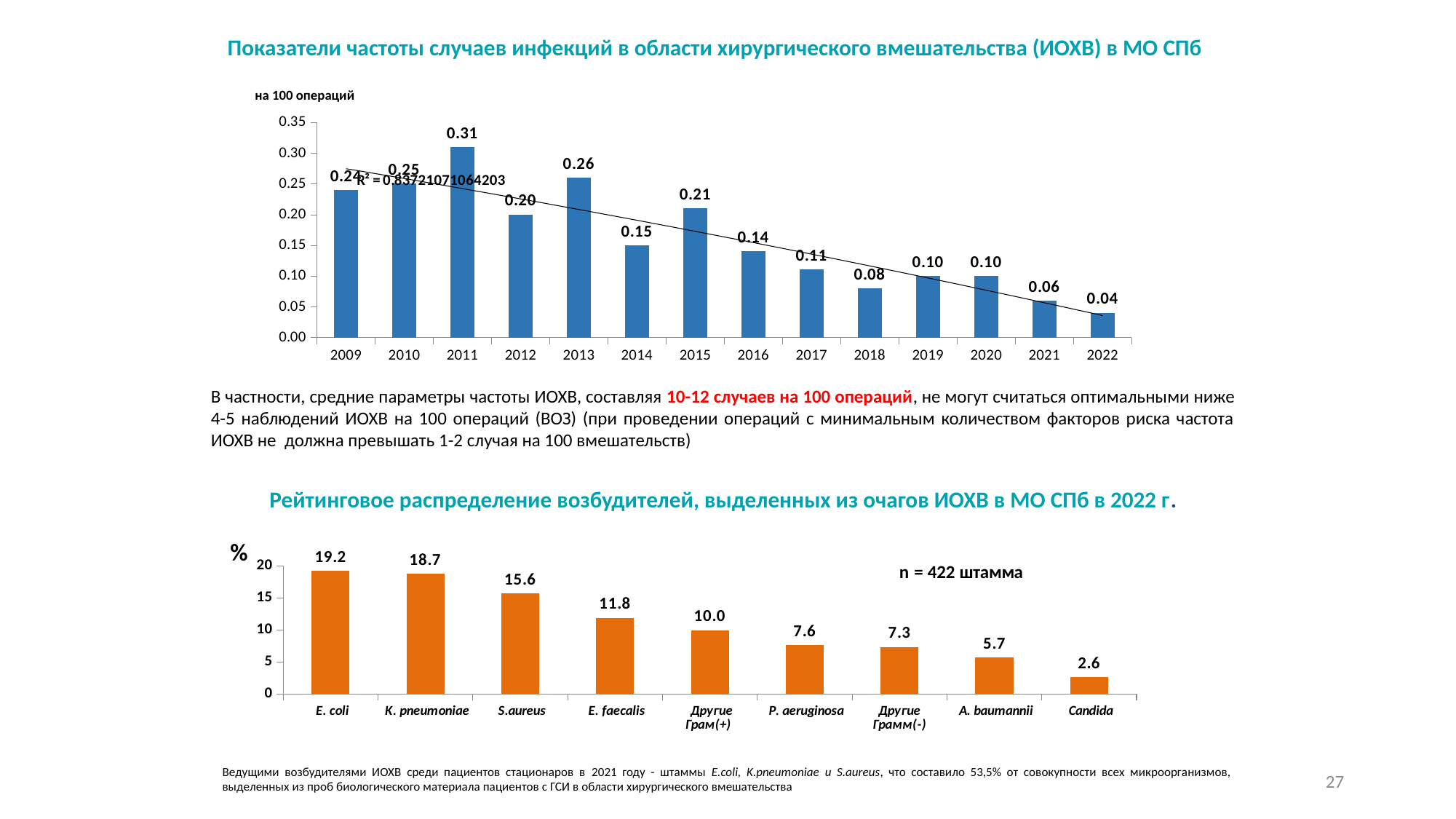
In the top chart (infection frequency per 100 operations), what is the difference between the values for 2013 and 2014? 0.11 In the top chart (infection frequency per 100 operations), what is the value for 2011? 0.31 In the top chart (infection frequency per 100 operations), how many years are shown on the x axis? 14 In the top chart (infection frequency per 100 operations), what is the value for 2022? 0.04 In the top chart (infection frequency per 100 operations), which year has the lowest value? 2022 In the bottom chart (pathogen distribution in 2022), which is larger, the value for P. aeruginosa or the value for A. baumannii? P. aeruginosa In the bottom chart (pathogen distribution in 2022), what is the value for S.aureus? 15.6 What kind of chart is the bottom chart (pathogen distribution in 2022)? bar chart In the bottom chart (pathogen distribution in 2022), which pathogen has the lowest share? Candida In the bottom chart (pathogen distribution in 2022), which pathogen has the highest share? E. coli In the top chart (infection frequency per 100 operations), do the values generally rise or fall from 2009 to 2022? fall In the top chart (infection frequency per 100 operations), which year has the highest value? 2011